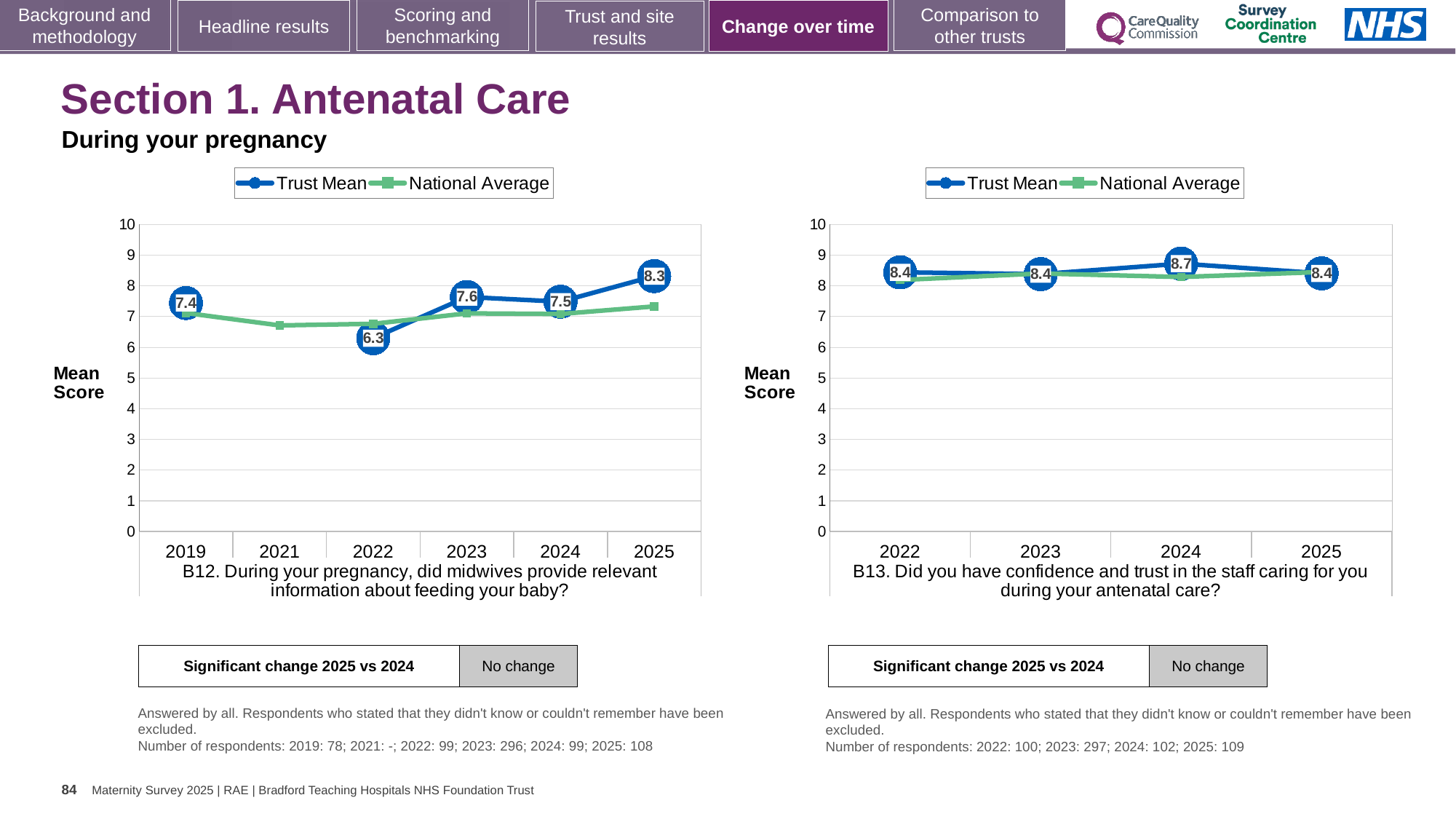
In the B12 chart (left), is the National Average for 2021 greater or less than 7? less In the B13 chart (right), what is the Trust Mean score for 2024? 8.7 In the B12 chart (left), what is the Trust Mean score for 2022? 6.3 In the B12 chart (left), what is the Trust Mean score for 2025? 8.3 In the B12 chart (left), which year has the lowest Trust Mean score? 2022 In the B13 chart (right), how many years are shown on the x axis? 4 In the B12 chart (left), does the Trust Mean rise or fall from 2022 to 2023? Rise In the B13 chart (right), which year has the highest Trust Mean score? 2024 In the B12 chart (left), what is the difference between the Trust Mean scores for 2025 and 2024? 0.8 In the B12 chart (left), which year has the highest Trust Mean score? 2025 In the B13 chart (right), how many series does the legend list? 2 What type of chart is the B12 chart on the left? Line chart